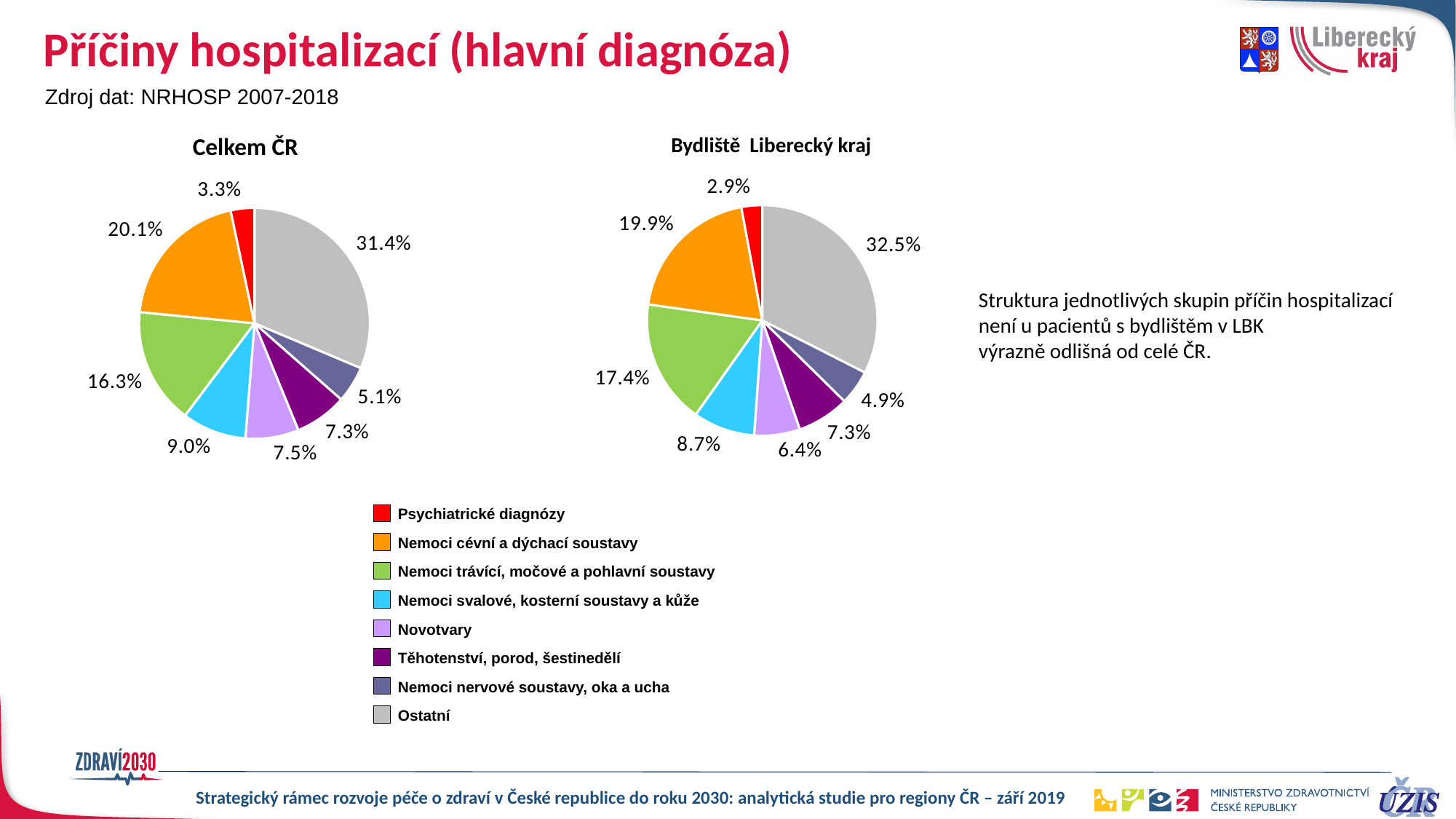
In the 'Celkem ČR' chart, what is the difference between the shares for Nemoci svalové, kosterní soustavy a kůže and Novotvary? 1.5% How many categories does the legend list for the pie charts? 8 What type of chart is used for 'Celkem ČR' and 'Bydliště Liberecký kraj'? pie chart Which chart shows a larger share for Nemoci trávící, močové a pohlavní soustavy, 'Celkem ČR' or 'Bydliště Liberecký kraj'? Bydliště Liberecký kraj In the 'Celkem ČR' chart, is the share for Psychiatrické diagnózy larger or smaller than the share for Nemoci nervové soustavy, oka a ucha? smaller In the 'Bydliště Liberecký kraj' chart, what share is labelled for Nemoci trávící, močové a pohlavní soustavy? 17.4% In the 'Celkem ČR' chart, which category has the largest slice? Ostatní In the 'Celkem ČR' chart, what share is labelled for Nemoci cévní a dýchací soustavy? 20.1% What is the difference between the Ostatní share in the 'Bydliště Liberecký kraj' chart and the Ostatní share in the 'Celkem ČR' chart? 1.1% In the 'Bydliště Liberecký kraj' chart, what share is labelled for Novotvary? 6.4% In the legend, which colour represents Těhotenství, porod, šestinedělí? dark purple In the 'Bydliště Liberecký kraj' chart, which category has the smallest slice? Psychiatrické diagnózy